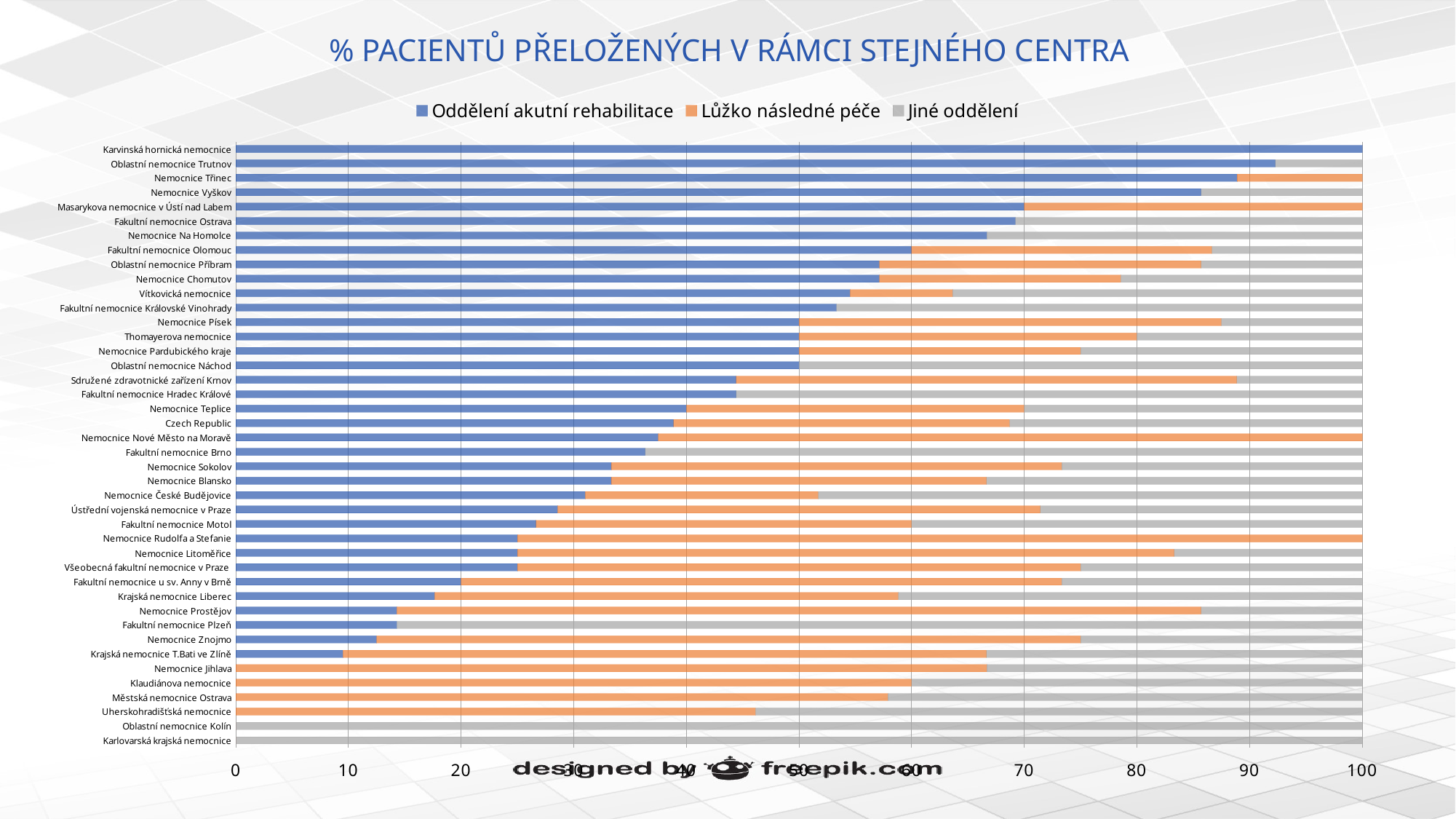
Is the value for Oddělení akutní rehabilitace at Krajská nemocnice T.Bati ve Zlíně greater or less than 20? less Is the value for Oddělení akutní rehabilitace at Nemocnice Vyškov greater or less than 80? greater Which series is shown in orange in the legend? Lůžko následné péče What is the title of the chart? % PACIENTŮ PŘELOŽENÝCH V RÁMCI STEJNÉHO CENTRA What kind of chart is shown on the slide? Stacked bar chart What is the value for Oddělení akutní rehabilitace at Karvinská hornická nemocnice? 100 How many hospitals (categories) are listed on the vertical axis? 42 Is the value for Oddělení akutní rehabilitace at Fakultní nemocnice Brno greater or less than 30? greater How many series does the legend list? 3 Which hospital has the highest value for Oddělení akutní rehabilitace? Karvinská hornická nemocnice Which has a larger value for Oddělení akutní rehabilitace: Nemocnice Vyškov or Nemocnice Znojmo? Nemocnice Vyškov